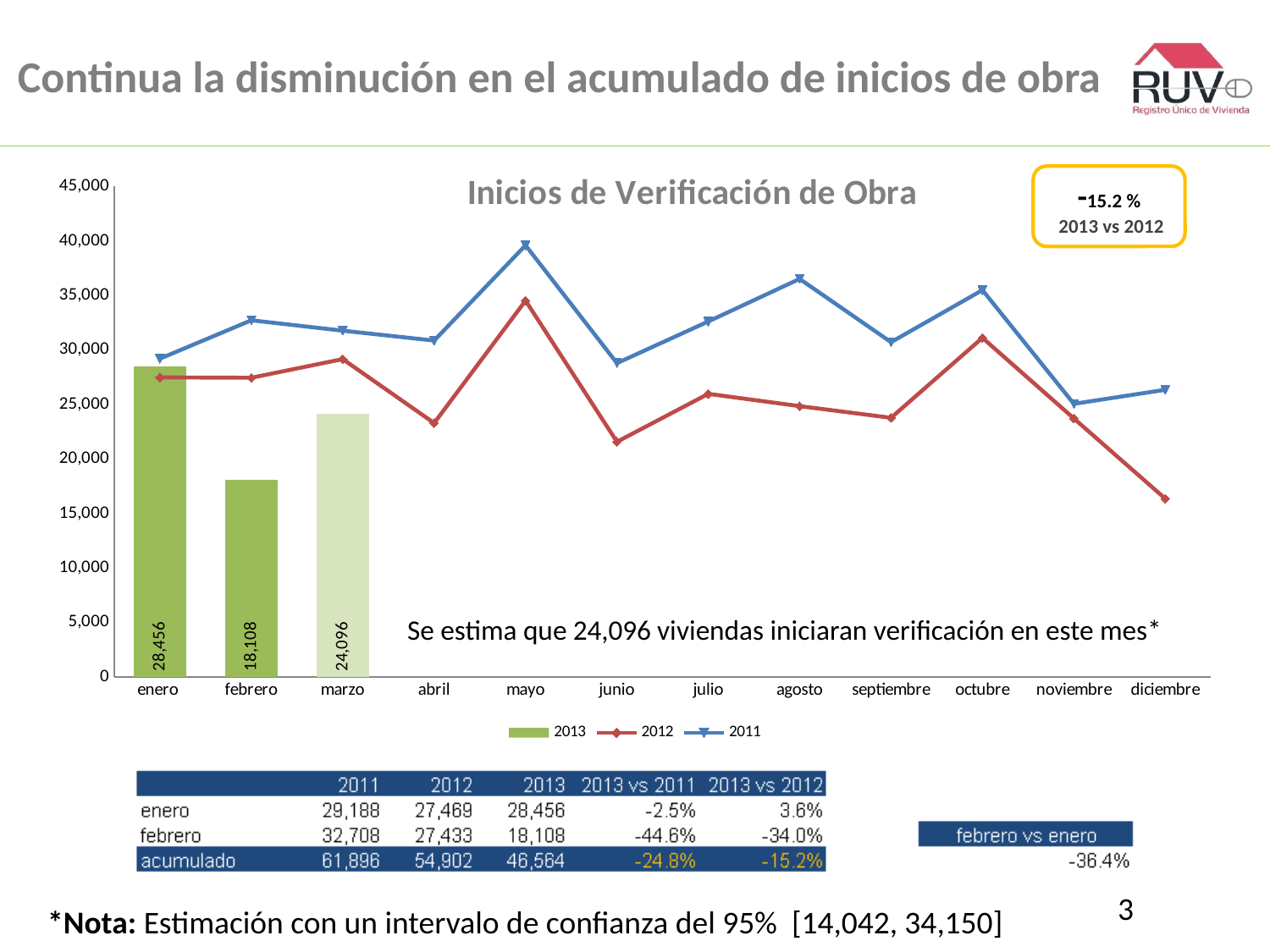
How many series does the legend list? 3 What is the value of the 2013 bar for enero? 28,456 Which is larger, the 2013 value for enero or for marzo? enero Is the 2012 value for diciembre greater or less than 20,000? less Which month has the lowest 2013 bar? febrero How many months are shown on the x axis? 12 Is the 2011 value for mayo greater or less than 35,000? greater Which month has the highest 2013 bar? enero In which month does the 2011 line reach its highest point? mayo What is the value of the 2013 bar for marzo? 24,096 What is the value of the 2013 bar for febrero? 18,108 What is the difference between the 2013 values for enero and febrero? 10,348